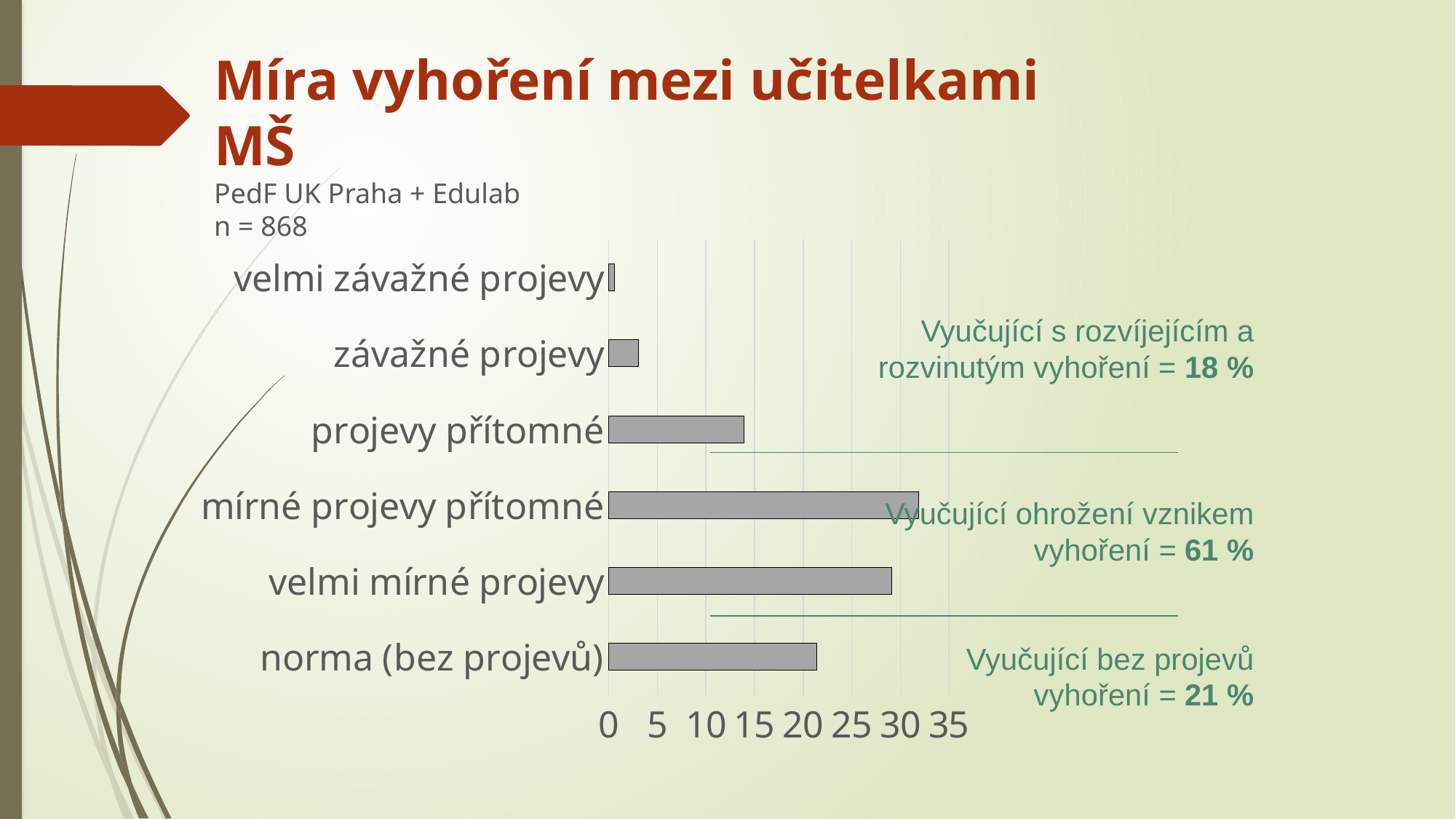
What kind of chart is shown on the slide? bar chart What is the title of the slide containing the chart? Míra vyhoření mezi učitelkami MŠ Is the value for norma (bez projevů) greater or less than 25? less How many categories does the bar chart show? 6 According to the annotation next to the chart, what percentage of teachers are 'Vyučující ohrožení vznikem vyhoření'? 61 % Which is larger, the value for norma (bez projevů) or the value for projevy přítomné? norma (bez projevů) Is the value for závažné projevy greater or less than 5? less Is the value for projevy přítomné greater or less than 10? greater Which is larger, the value for velmi mírné projevy or the value for norma (bez projevů)? velmi mírné projevy Which category has the shortest bar in the chart? velmi závažné projevy Which category has the longest bar in the chart? mírné projevy přítomné